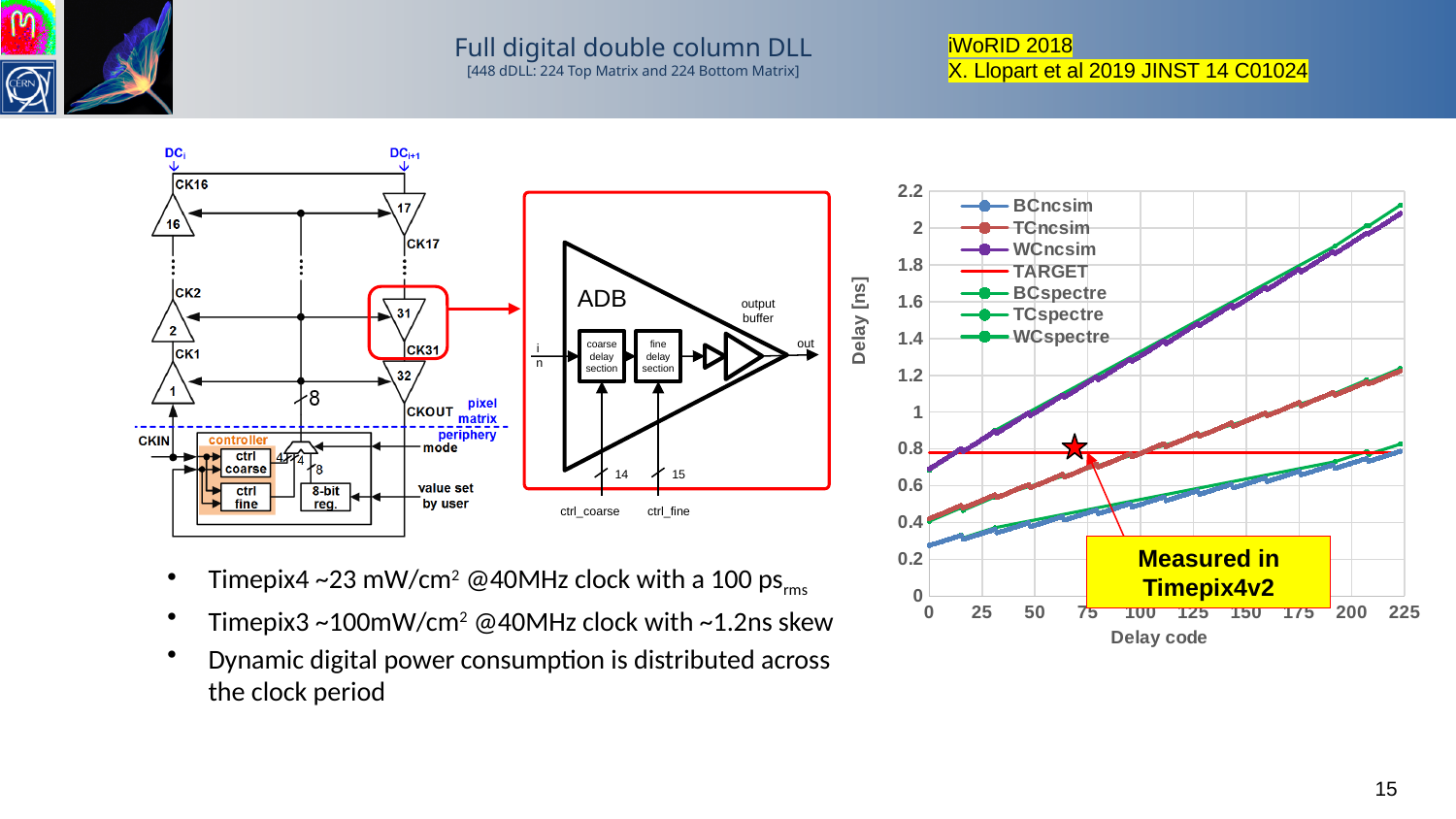
In the delay chart, is the value of BCncsim at delay code 225 greater or less than 1? less In the delay chart, is the TARGET line greater or less than 1? less What is the label of the y axis of the delay chart? Delay [ns] In the delay chart, which series has the larger value at delay code 150, TCncsim or BCncsim? TCncsim How many series does the legend of the delay chart list? 7 In the delay chart, is the value of WCncsim at delay code 200 greater or less than 1.8? greater In the delay chart, does the WCncsim series rise or fall as the delay code increases? rise What kind of chart is shown on the right side of the slide? line chart In the delay chart, which series has the larger value at delay code 100, WCncsim or BCncsim? WCncsim What is the label of the x axis of the delay chart? Delay code